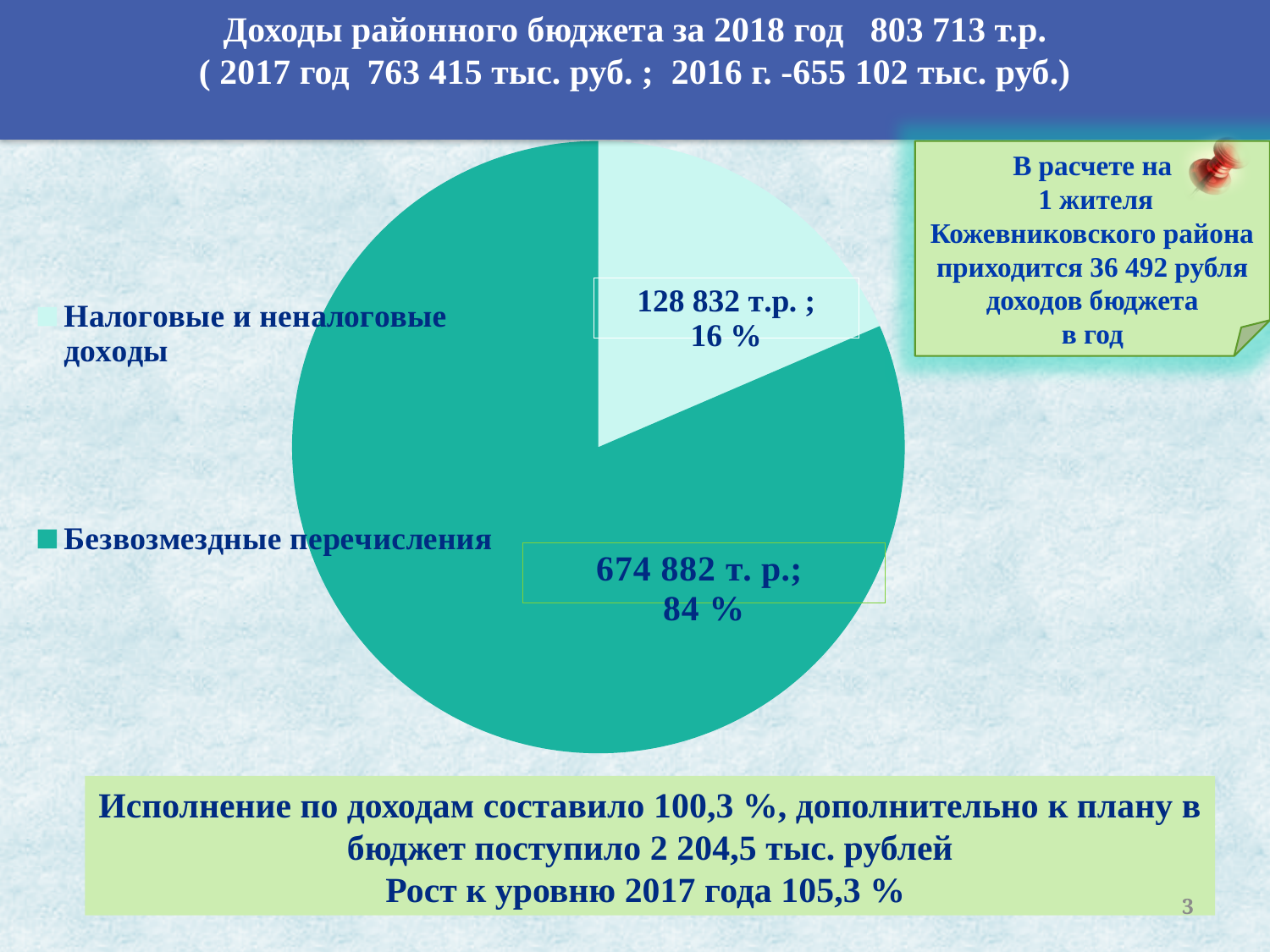
What kind of chart is shown on the slide? pie chart How many slices does the pie chart have? 2 How many entries does the legend of the pie chart list? 2 Which legend entry is shown in the lighter colour in the pie chart? Налоговые и неналоговые доходы By how much does Безвозмездные перечисления exceed Налоговые и неналоговые доходы, in т.р.? 546 050 What value is shown for Налоговые и неналоговые доходы in the pie chart? 128 832 т.р. What share of the pie does Налоговые и неналоговые доходы represent? 16 % Which slice of the pie chart is the smallest? Налоговые и неналоговые доходы Which is larger: Безвозмездные перечисления or Налоговые и неналоговые доходы? Безвозмездные перечисления What share of the pie does Безвозмездные перечисления represent? 84 % What value is shown for Безвозмездные перечисления in the pie chart? 674 882 т. р. Which slice of the pie chart is the largest? Безвозмездные перечисления